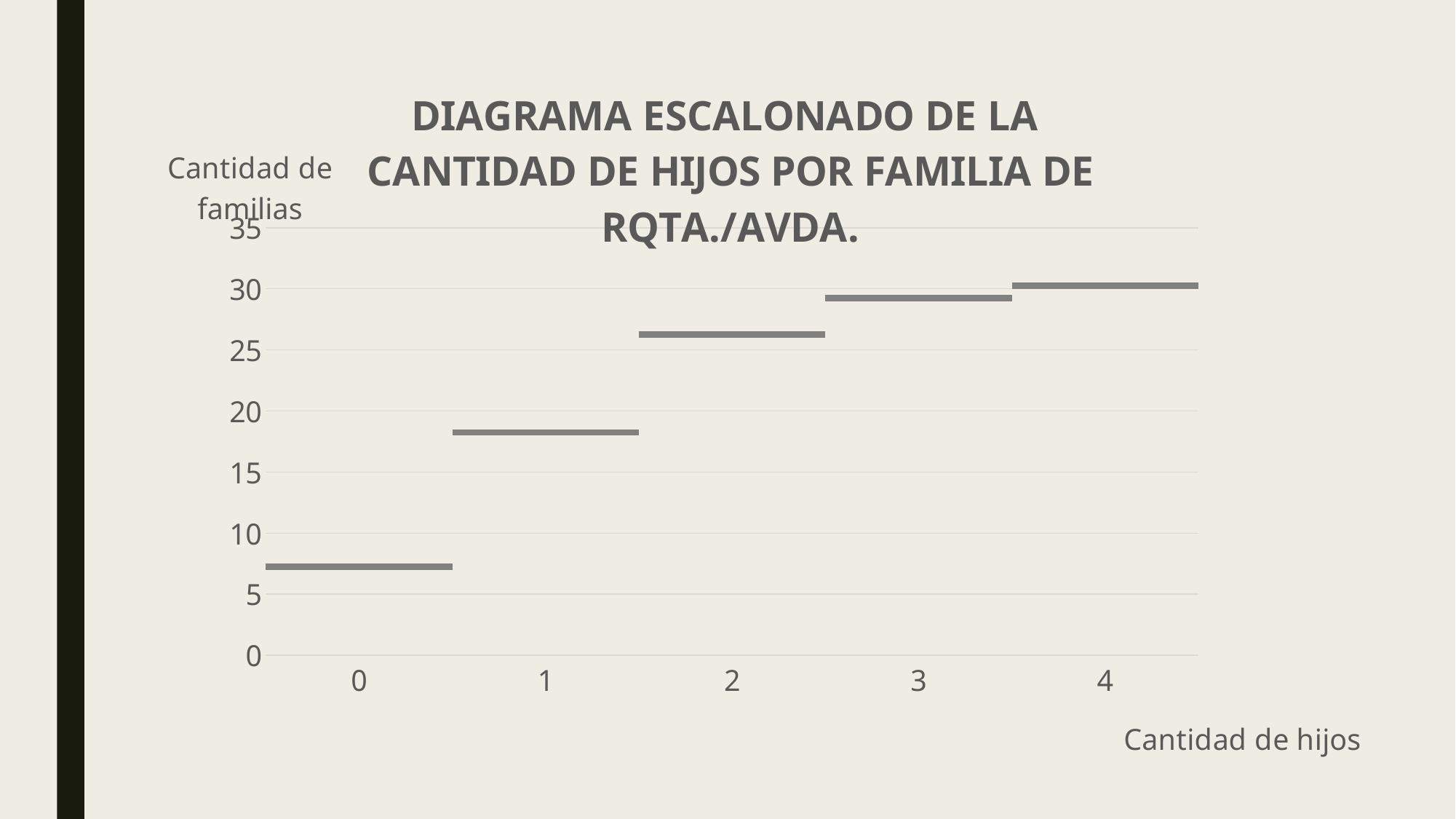
What is the label of the horizontal axis? Cantidad de hijos What is the title of the chart? DIAGRAMA ESCALONADO DE LA CANTIDAD DE HIJOS POR FAMILIA DE RQTA./AVDA. Do the values rise or fall as Cantidad de hijos increases along the x axis? rise Which is larger, the value for 1 hijo or the value for 3 hijos? 3 hijos Is the value for 0 hijos greater or less than 10? less Which Cantidad de hijos value has the highest Cantidad de familias on the chart? 4 Is the value for 1 hijo greater or less than 15? greater What kind of chart is shown on the slide? step chart Which Cantidad de hijos value has the lowest Cantidad de familias on the chart? 0 How many steps (categories of Cantidad de hijos) are plotted on the chart? 5 Is the value for 2 hijos greater or less than 25? greater